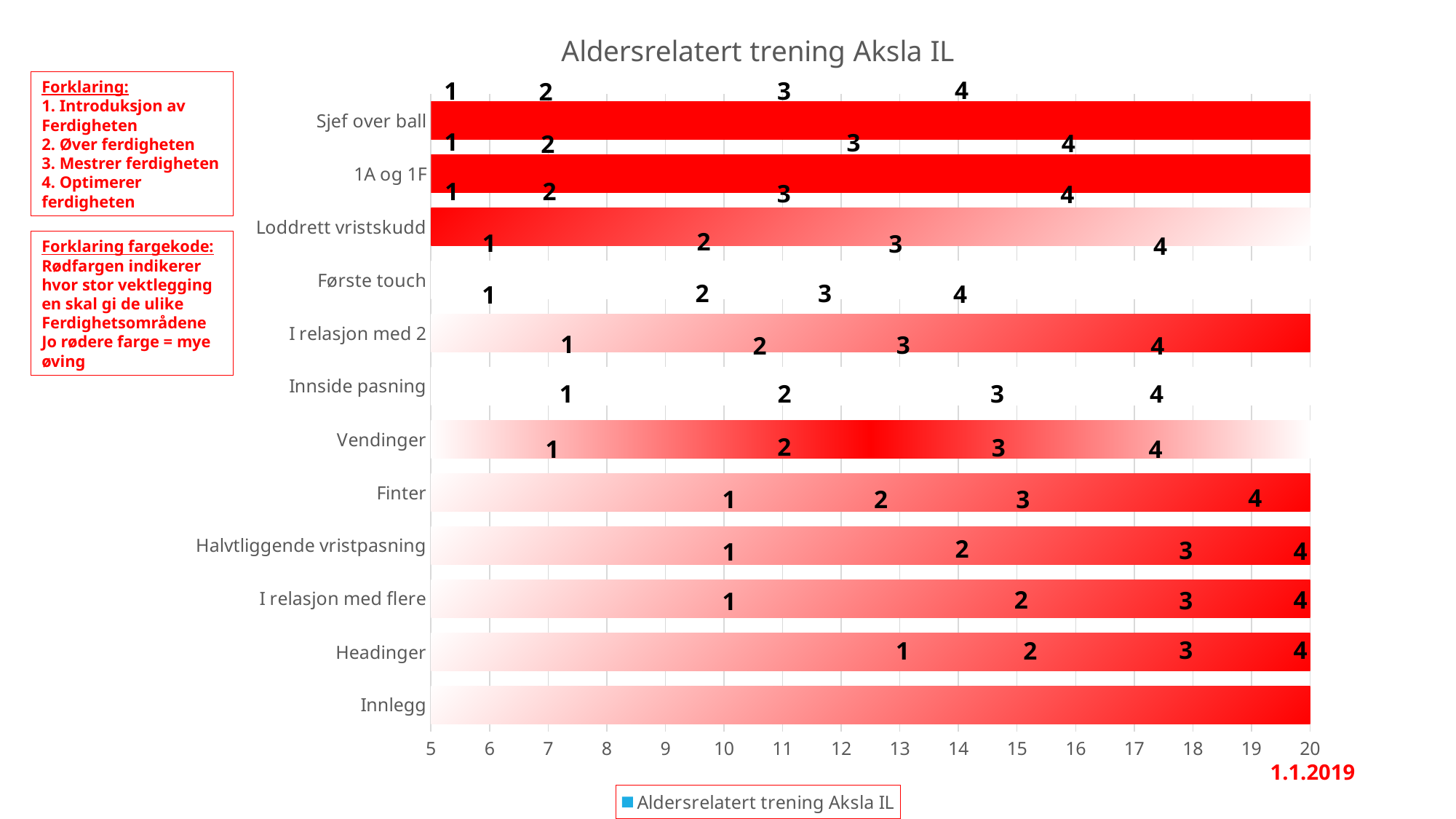
What is the highest tick value shown on the horizontal axis of the chart? 20 Does the bar for Innlegg extend to a value greater or less than 10 on the horizontal axis? greater How many series does the chart legend list? 1 How many categories are listed on the vertical axis of the chart? 12 Does the bar for Sjef over ball extend to a value greater or less than 15 on the horizontal axis? greater What is the title of the chart? Aldersrelatert trening Aksla IL What kind of chart is shown on the slide? bar chart